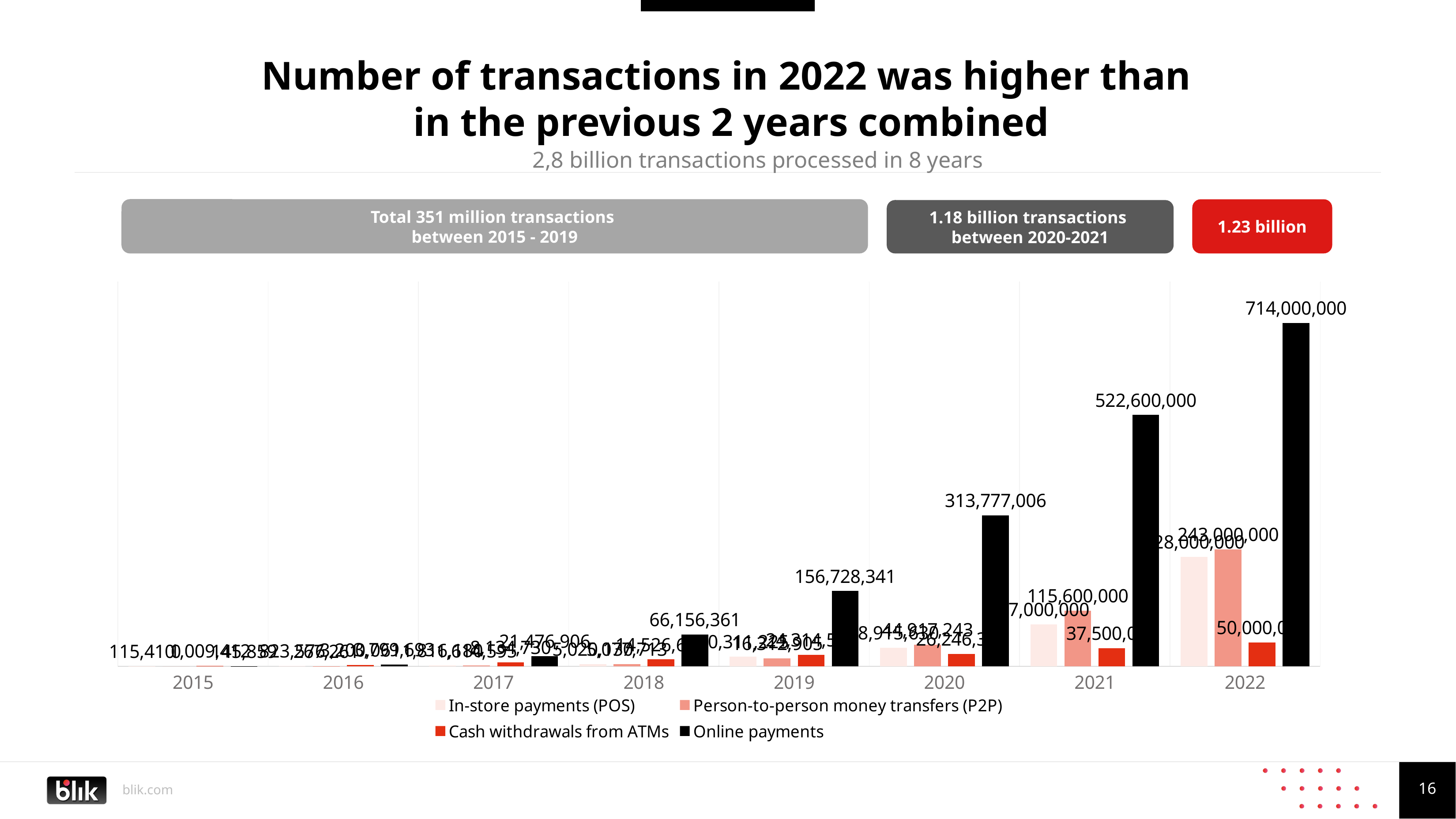
What is the value for Online payments in 2020? 313,777,006 How many years are shown on the x axis of the chart? 8 What kind of chart is shown on the slide? bar chart Which is larger: Online payments in 2020 or Online payments in 2019? 2020 How many series does the legend list? 4 In which year is the value for Online payments highest? 2022 What is the value for Online payments in 2022? 714,000,000 What is the difference between Online payments in 2022 and in 2021? 191,400,000 What is the value for Online payments in 2021? 522,600,000 What is the value for Online payments in 2018? 66,156,361 Do the values for Online payments rise or fall from 2015 to 2022? rise What is the value for Online payments in 2019? 156,728,341